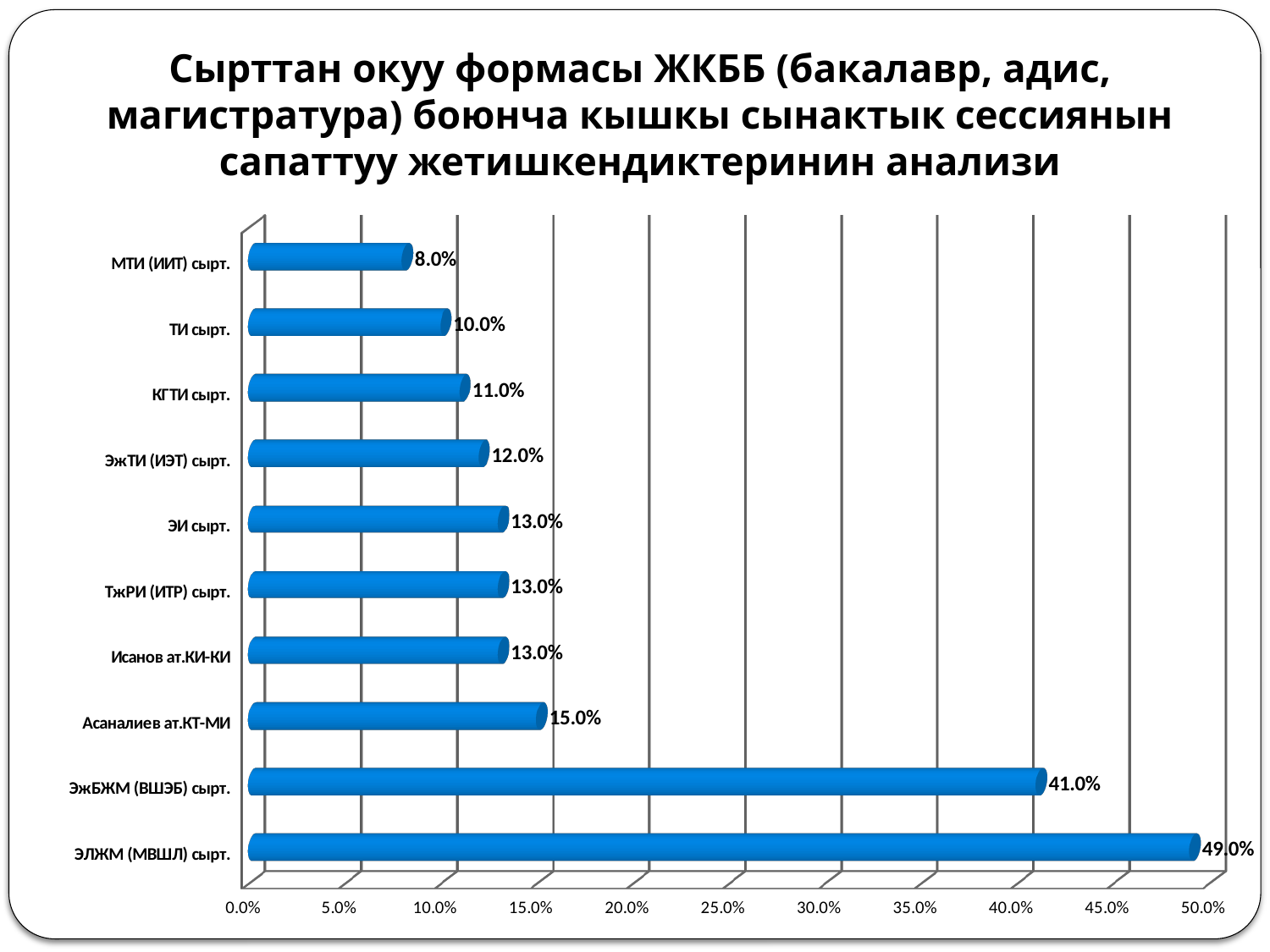
What is the difference between the values for Асаналиев ат.КТ-МИ and МТИ (ИИТ) сырт.? 7.0% What kind of chart is shown on the slide? bar chart How many categories are shown in the chart? 10 What is the value for ЭЛЖМ (МВШЛ) сырт.? 49.0% Which category has the lowest value? МТИ (ИИТ) сырт. What is the maximum value shown on the horizontal axis? 50.0% Which category has the highest value? ЭЛЖМ (МВШЛ) сырт. What is the value for Асаналиев ат.КТ-МИ? 15.0% What is the difference between the values for ЭЛЖМ (МВШЛ) сырт. and ЭжБЖМ (ВШЭБ) сырт.? 8.0% What is the value for ТИ сырт.? 10.0% Which is larger, the value for КГТИ сырт. or the value for ЭжТИ (ИЭТ) сырт.? ЭжТИ (ИЭТ) сырт. Is the value for ЭжБЖМ (ВШЭБ) сырт. greater or less than 40.0%? greater